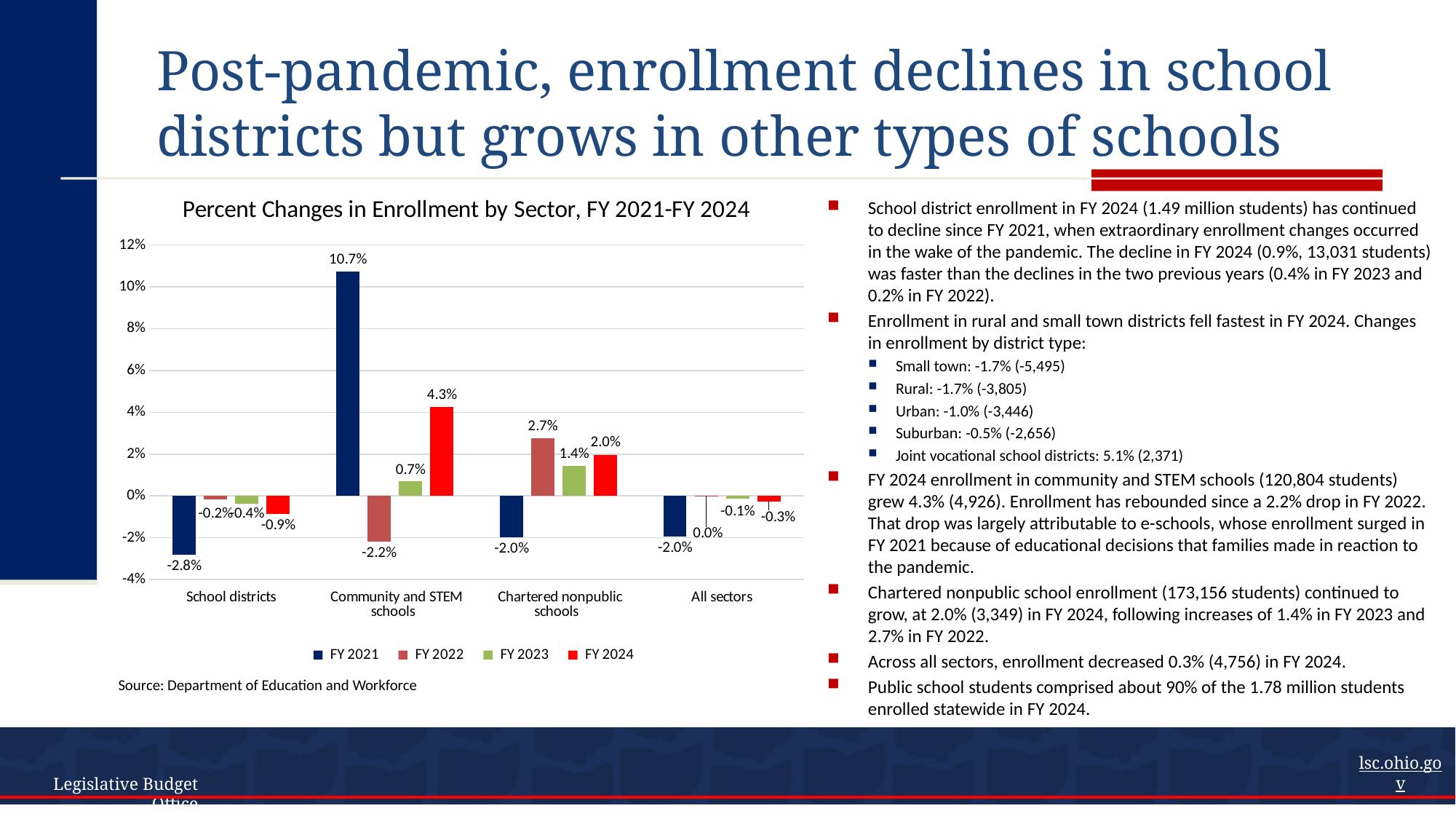
What is the FY 2024 value for School districts? -0.9% What kind of chart is shown on the slide? Bar chart How many series does the legend list? 4 Which category has the highest FY 2024 value? Community and STEM schools What is the FY 2022 value for Chartered nonpublic schools? 2.7% Which category has the lowest FY 2021 value? School districts What is the difference between the FY 2024 values for Community and STEM schools and Chartered nonpublic schools? 2.3% What is the FY 2023 value for All sectors? -0.1% How many categories are shown on the x axis? 4 Is the FY 2021 value for Community and STEM schools greater or less than 10%? greater What is the FY 2021 value for Community and STEM schools? 10.7% Which is larger for Chartered nonpublic schools: the FY 2022 value or the FY 2023 value? FY 2022